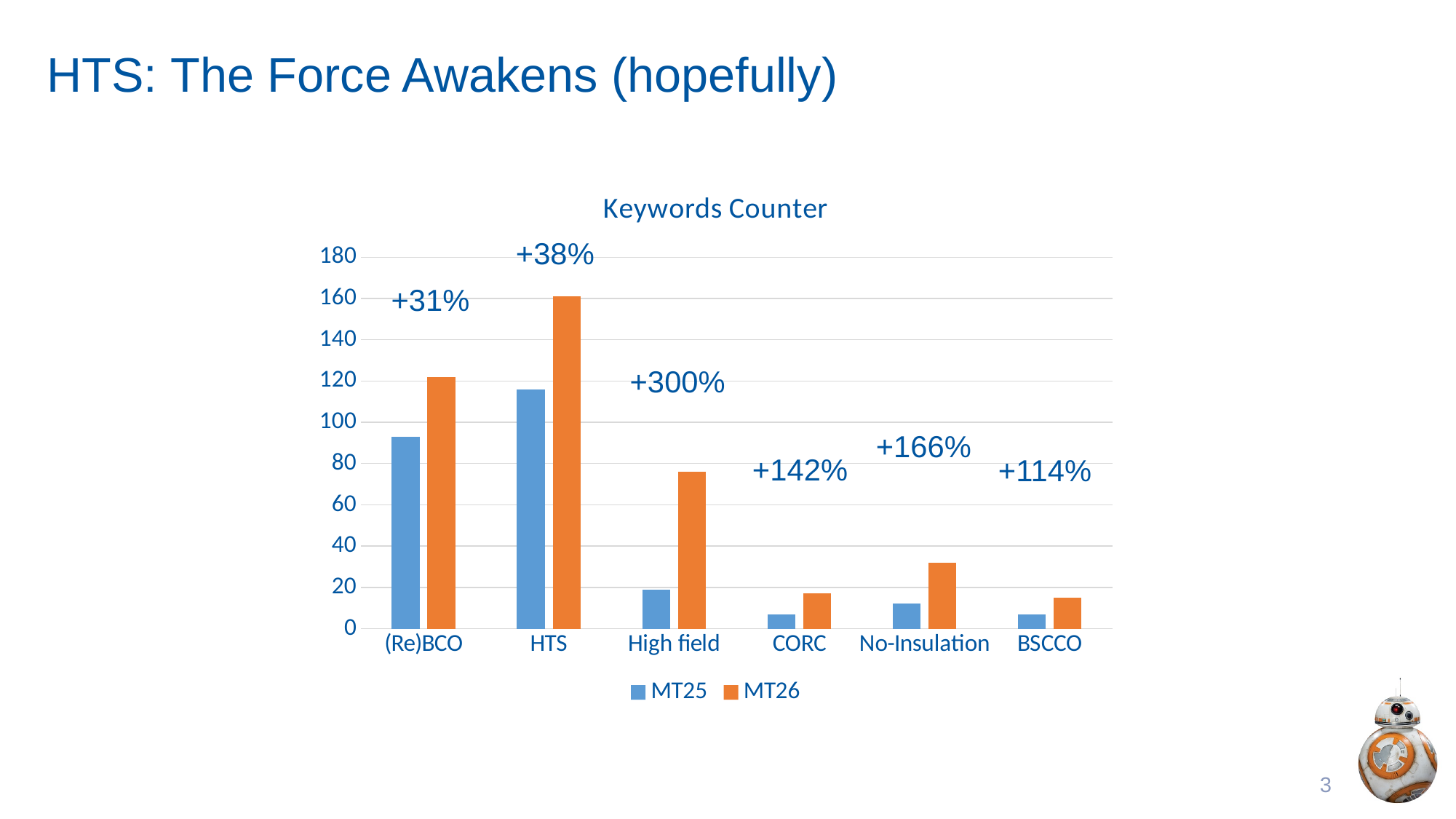
What percentage change is annotated above the High field bars? +300% How many series does the legend list in the Keywords Counter chart? 2 How many categories are shown on the x axis of the Keywords Counter chart? 6 What kind of chart is shown on the slide? bar chart Is the MT26 value for High field greater or less than 60? greater Which category has the highest MT25 bar? HTS Which category has the highest MT26 bar? HTS What is the title of the chart? Keywords Counter Is the MT26 value for HTS greater or less than 140? greater Which is larger, the MT25 value for High field or the MT25 value for No-Insulation? High field Which is larger, the MT26 value for (Re)BCO or the MT26 value for HTS? HTS Is the MT25 value for (Re)BCO greater or less than 100? less